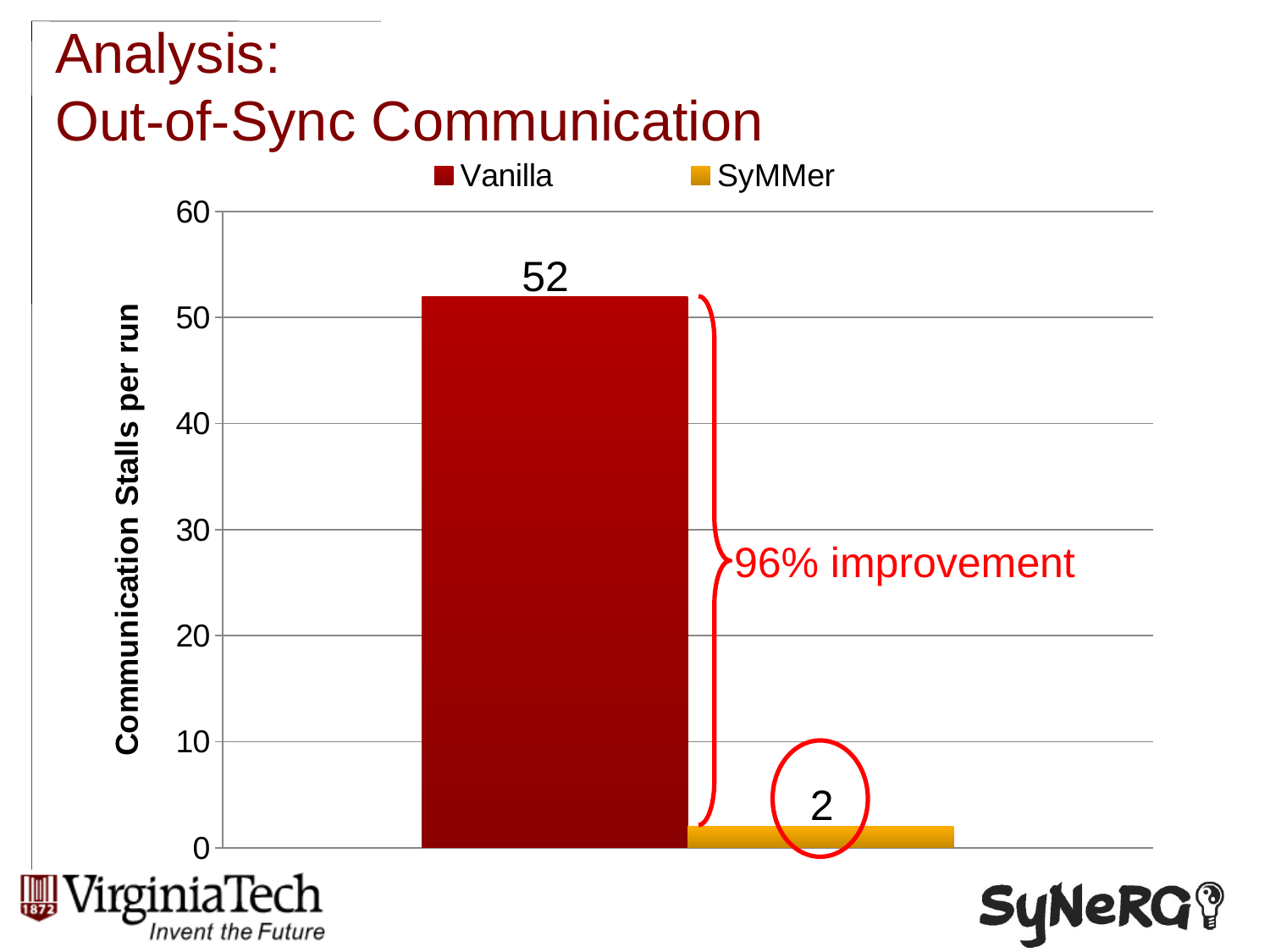
Which is larger, the value for Vanilla or the value for SyMMer? Vanilla What is the difference between the Vanilla and SyMMer values? 50 Is the value for Vanilla greater or less than 50? greater What improvement percentage is annotated on the chart? 96% improvement What kind of chart is shown on the slide? bar chart Is the value for SyMMer greater or less than 10? less What is the value for Vanilla? 52 Which series has the lowest number of communication stalls per run? SyMMer How many series does the legend list? 2 What is the label of the vertical axis? Communication Stalls per run What is the value for SyMMer? 2 Which series has the highest number of communication stalls per run? Vanilla